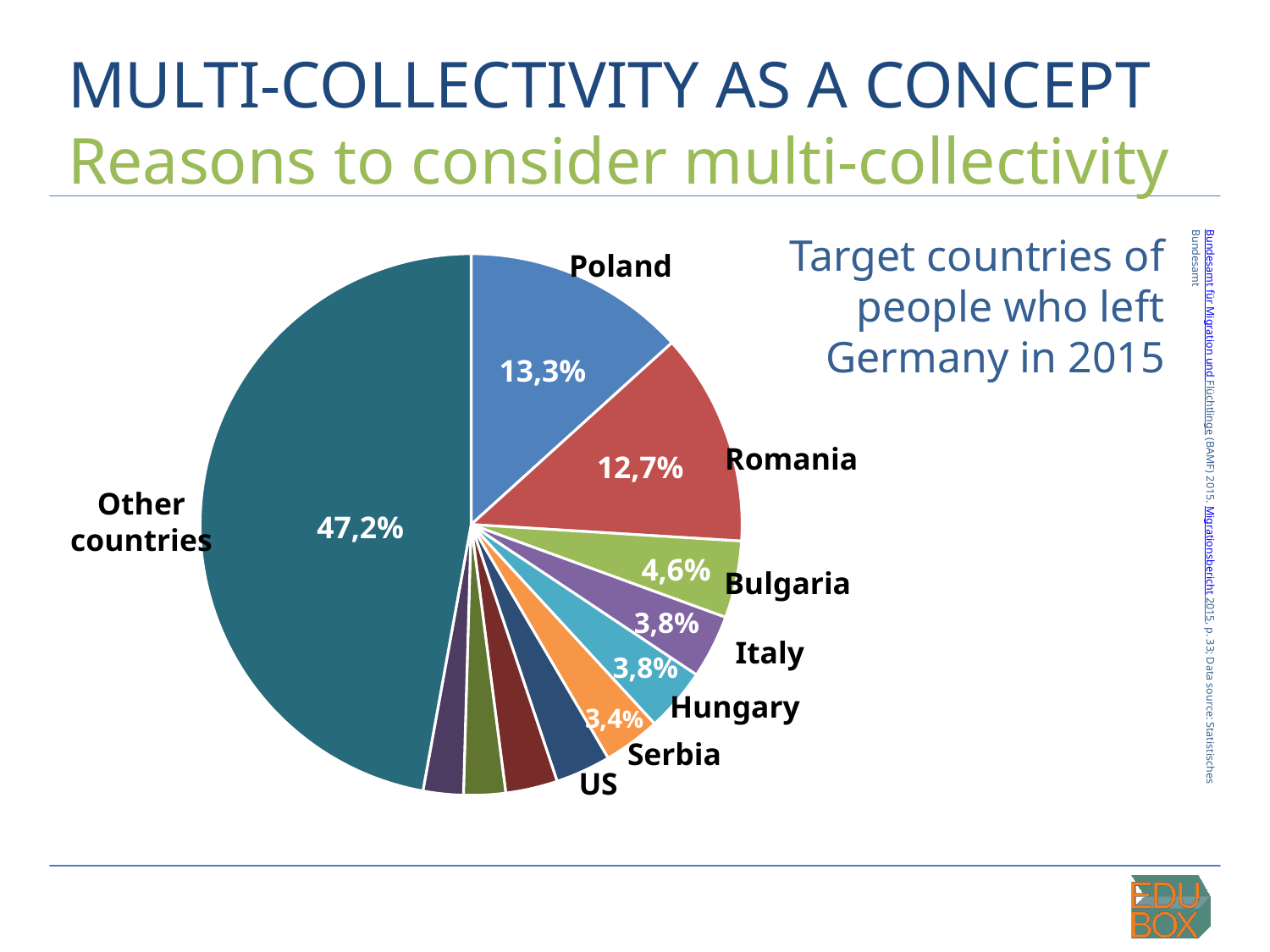
What percentage is shown for Italy? 3,8% What is the title of the chart? Target countries of people who left Germany in 2015 What percentage is shown for Other countries? 47,2% What percentage is shown for Bulgaria? 4,6% What share of the pie does Poland have? 13,3% What is the difference between the shares of Bulgaria and Serbia? 1,2% Which category has the largest slice of the pie? Other countries What kind of chart is shown on the slide? pie chart What percentage is shown for Serbia? 3,4% What is the difference between the shares of Poland and Romania? 0,6% Which has the larger share, Poland or Romania? Poland What percentage is shown for Romania? 12,7%